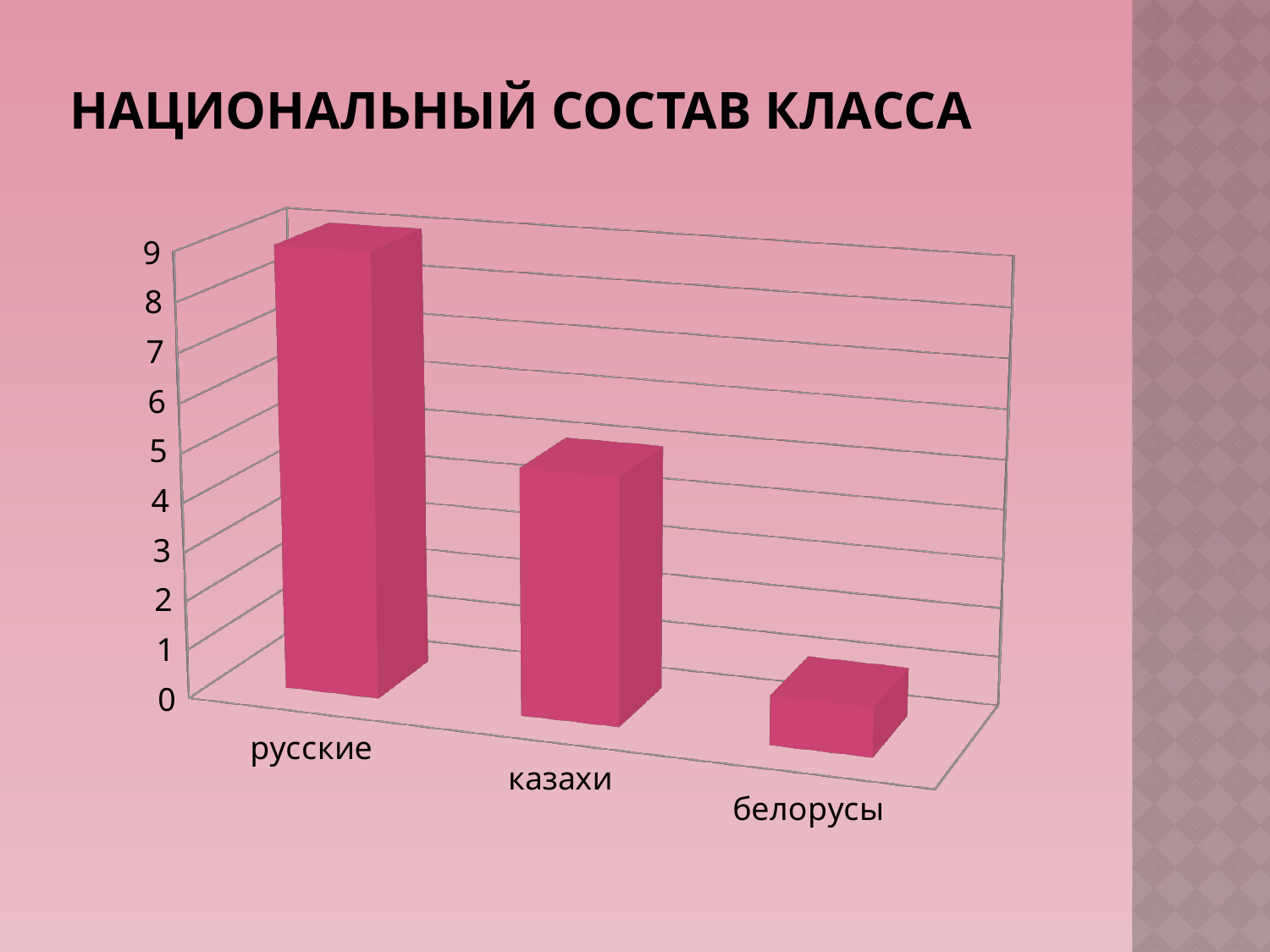
Do the values rise or fall from left to right along the x axis? fall Is the value for русские greater or less than 5? greater Is the value for белорусы greater or less than 3? less Which is larger, the value for русские or the value for казахи? русские Which category has the lowest value? белорусы Is the value for казахи greater or less than 8? less What is the highest value shown on the vertical axis? 9 What kind of chart is shown on the slide? bar chart Which is larger, the value for казахи or the value for белорусы? казахи Which category has the highest value? русские What is the title of the slide? НАЦИОНАЛЬНЫЙ СОСТАВ КЛАССА How many categories are shown on the chart? 3